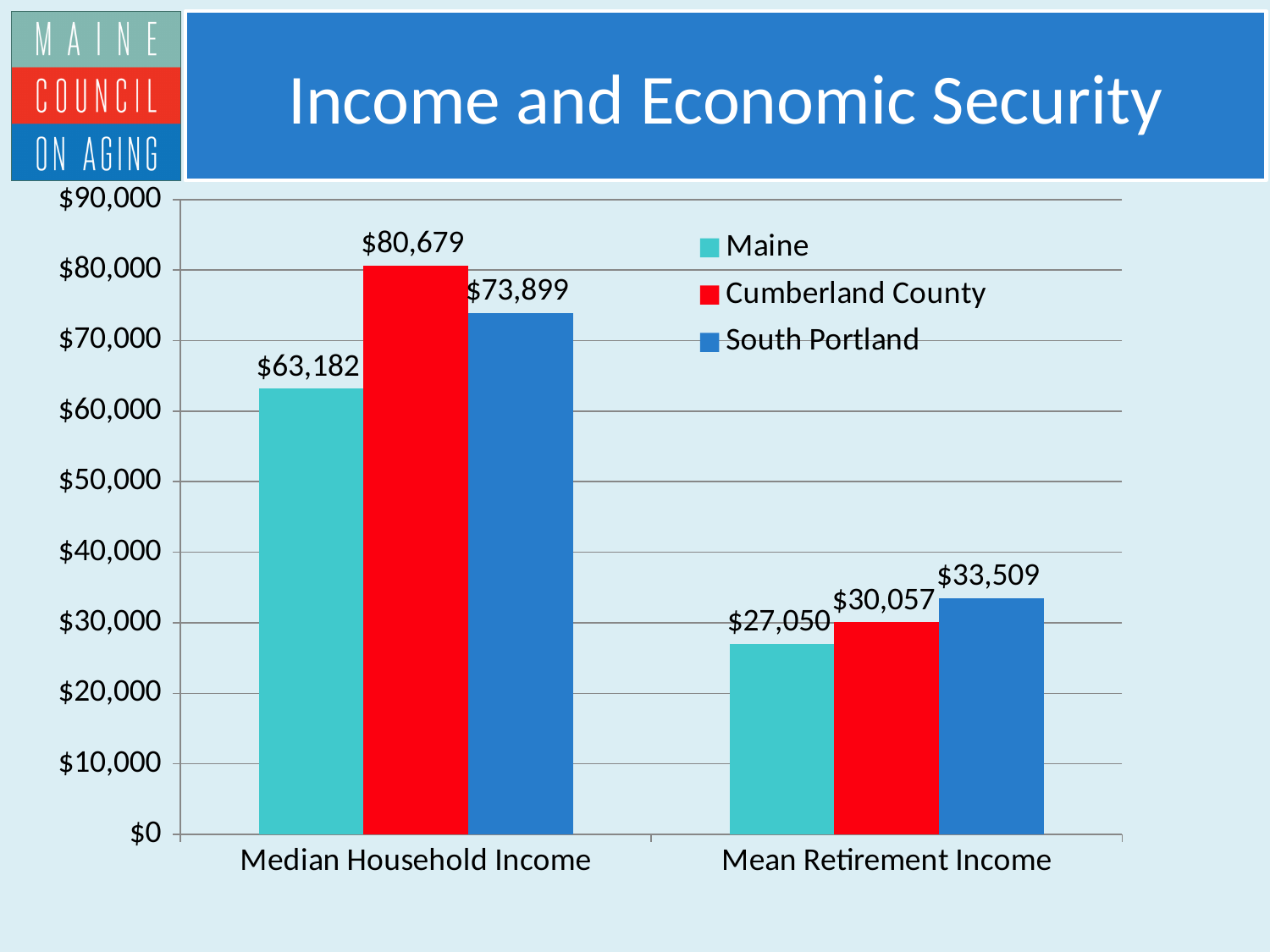
What is the Median Household Income for Cumberland County? $80,679 How many categories are shown on the x axis? 2 Which series has the highest Median Household Income? Cumberland County What is the difference between South Portland's and Cumberland County's Mean Retirement Income? $3,452 What is the Mean Retirement Income for Maine? $27,050 Which series has the lowest Mean Retirement Income? Maine What kind of chart is shown on the slide? Bar chart How many series does the legend list? 3 What is the Median Household Income for South Portland? $73,899 Is the Mean Retirement Income for South Portland greater or less than $30,000? greater What is the difference between Cumberland County's and Maine's Median Household Income? $17,497 Which is larger: South Portland's Median Household Income or Cumberland County's Median Household Income? Cumberland County's Median Household Income